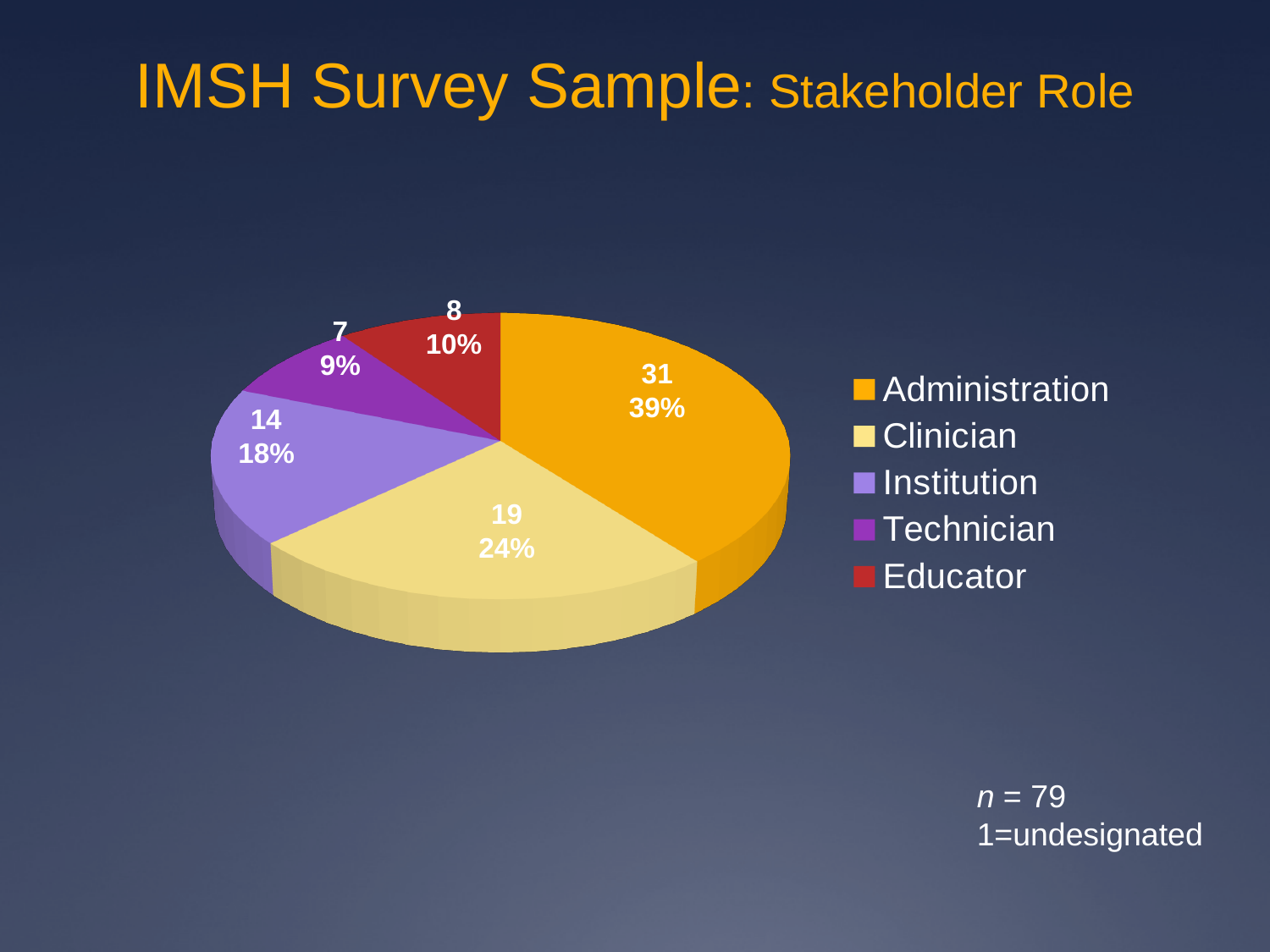
What is the difference between the Administration count and the Clinician count? 12 Which stakeholder role has the smallest slice? Technician What kind of chart is shown on the slide? Pie chart What is the count for Institution? 14 Which is larger, the Institution count or the Educator count? Institution What is the count for Educator? 8 What percentage share does Technician have? 9% What is the count for Administration? 31 What colour is the Educator slice? Red How many stakeholder roles are shown in the pie chart? 5 Which stakeholder role has the largest slice? Administration What percentage share does Clinician have? 24%